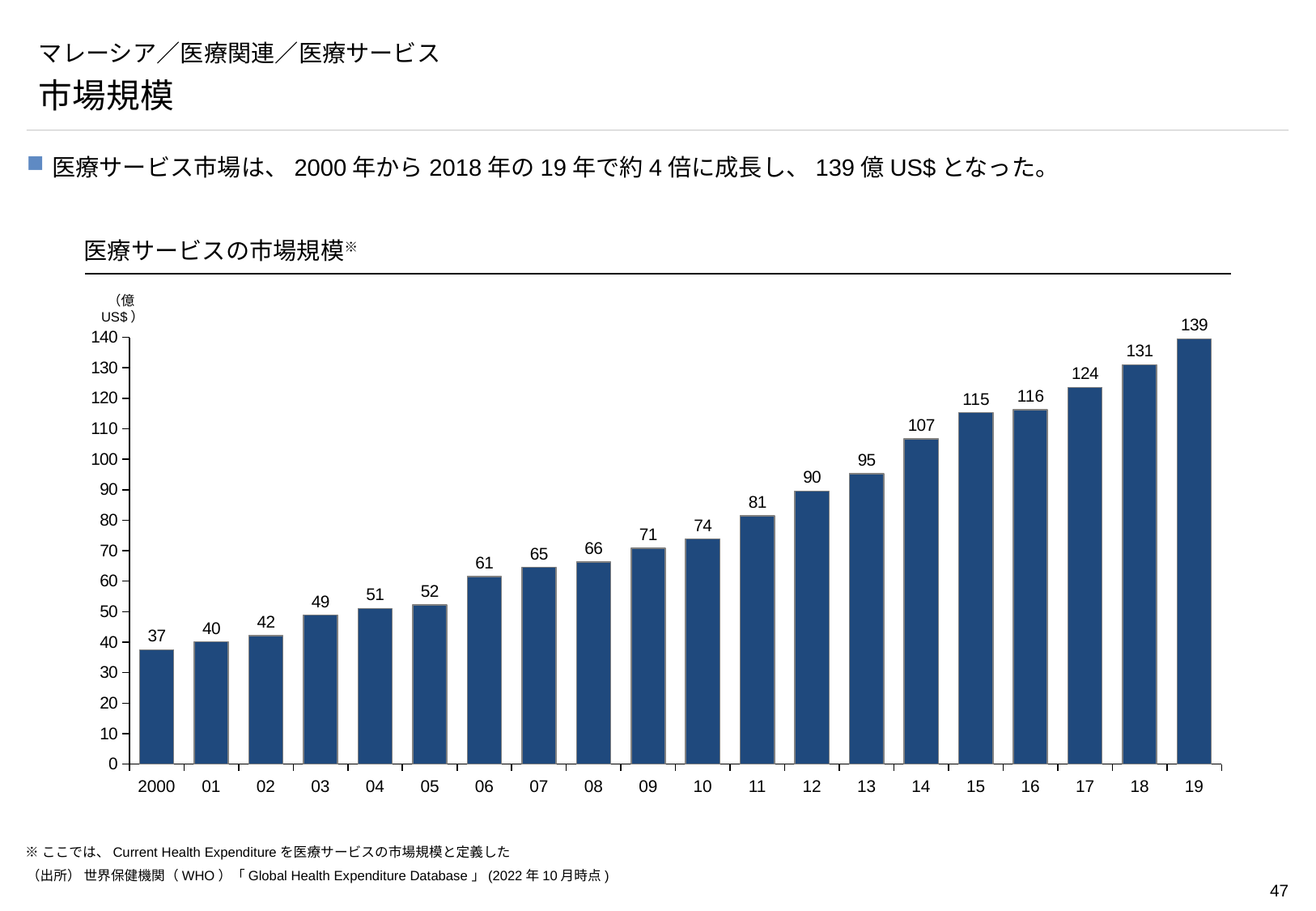
What is the value for 2000? 37 What is the title of the chart? 医療サービスの市場規模 What is the difference between the values for 15 and 14? 8 How many years are shown on the x axis? 20 What is the difference between the values for 19 and 2000? 102 What is the value for 10? 74 Do the values rise or fall from 2000 to 19? rise Which year has the lowest value? 2000 What kind of chart is this? bar chart What is the value for 19? 139 Which year has the highest value? 19 Which is larger, the value for 08 or the value for 09? 09